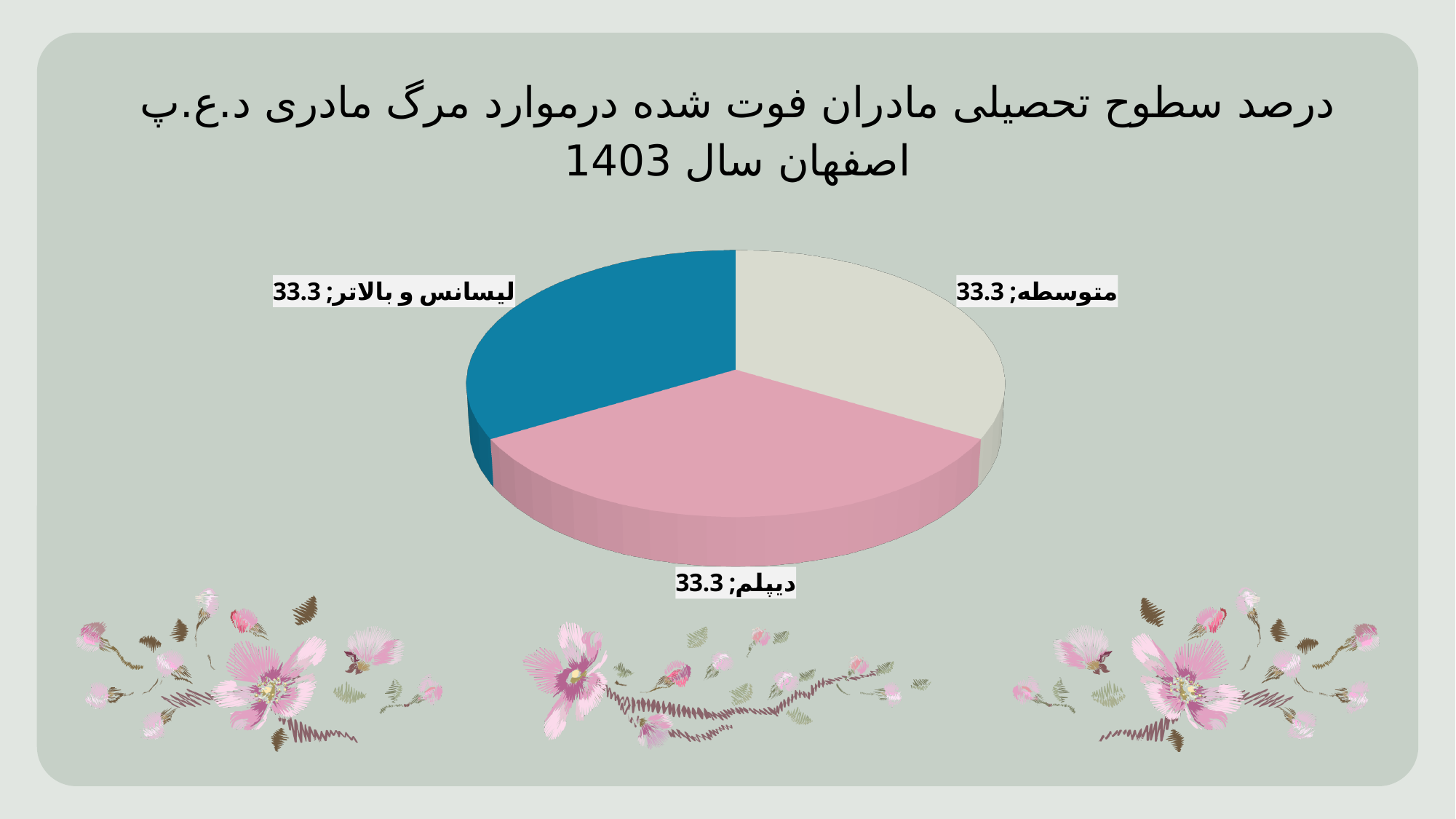
What kind of chart is shown on the slide? pie chart What is the value shown for the متوسطه slice? 33.3 Which slice of the pie chart is coloured blue? لیسانس و بالاتر What share of the pie does the دیپلم slice represent? 33.3 What is the value shown for the دیپلم slice? 33.3 What is the value shown for the لیسانس و بالاتر slice? 33.3 How many slices does the pie chart have? 3 What is the difference between the values for متوسطه and دیپلم? 0 Which year is mentioned in the chart title? 1403 Which slice of the pie chart is coloured pink? دیپلم